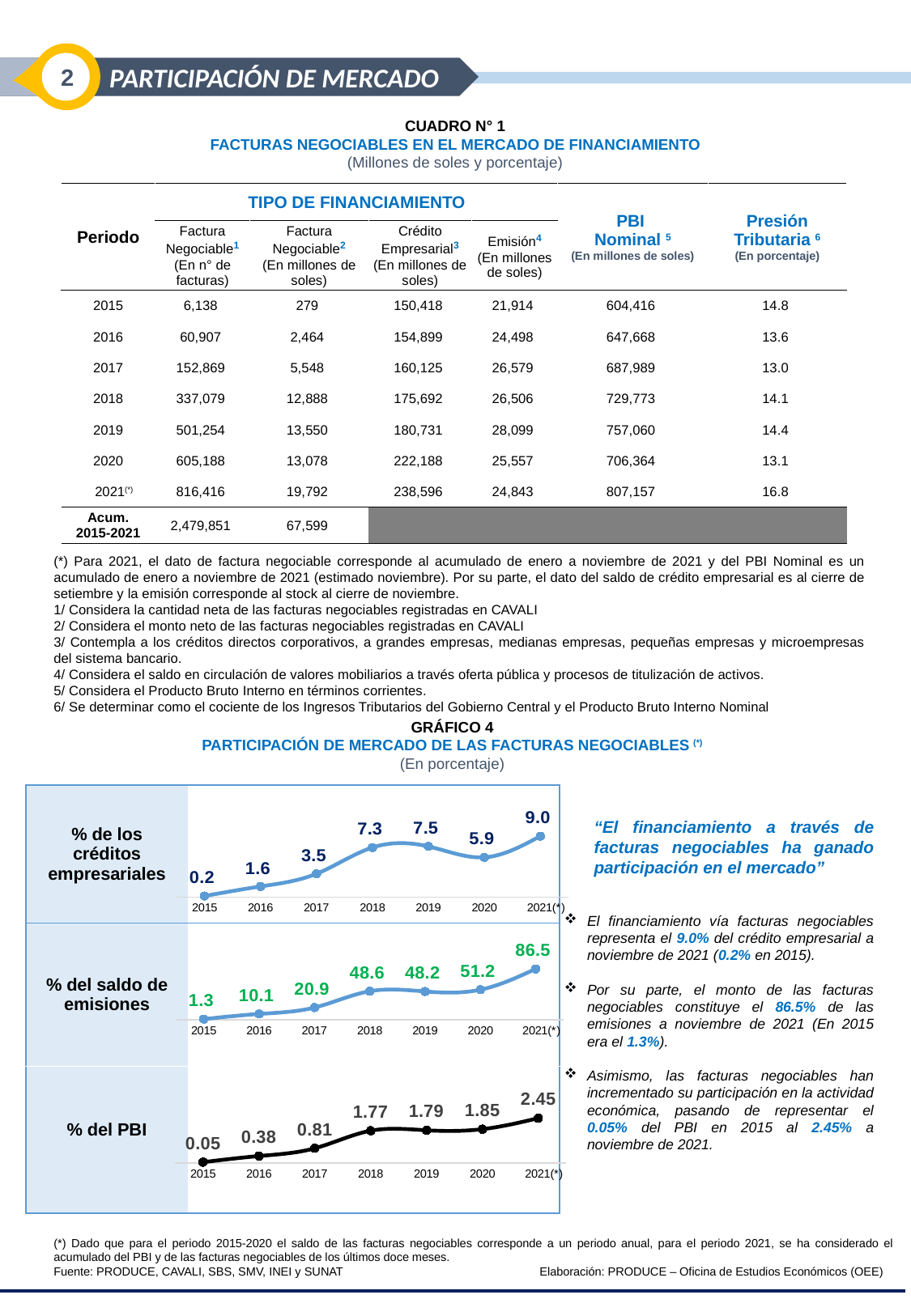
What is the title of Gráfico 4? PARTICIPACIÓN DE MERCADO DE LAS FACTURAS NEGOCIABLES In the '% de los créditos empresariales' chart, which year has the lowest value? 2015 In the '% del saldo de emisiones' chart, what is the difference between the 2021(*) value and the 2015 value? 85.2 In the '% de los créditos empresariales' chart, what is the value for 2018? 7.3 In the '% del PBI' chart, do the values generally rise or fall from 2015 to 2021(*)? Rise How many data points are plotted in the '% del PBI' chart? 7 In the '% del PBI' chart, what is the value for 2019? 1.79 In the '% del saldo de emisiones' chart, which is larger, the value for 2018 or the value for 2019? 2018 In the '% del PBI' chart, what is the difference between the 2021(*) value and the 2020 value? 0.60 What type of chart is used for '% de los créditos empresariales'? Line chart In the '% del saldo de emisiones' chart, what is the value for 2020? 51.2 In the '% de los créditos empresariales' chart, which year has the highest value? 2021(*)